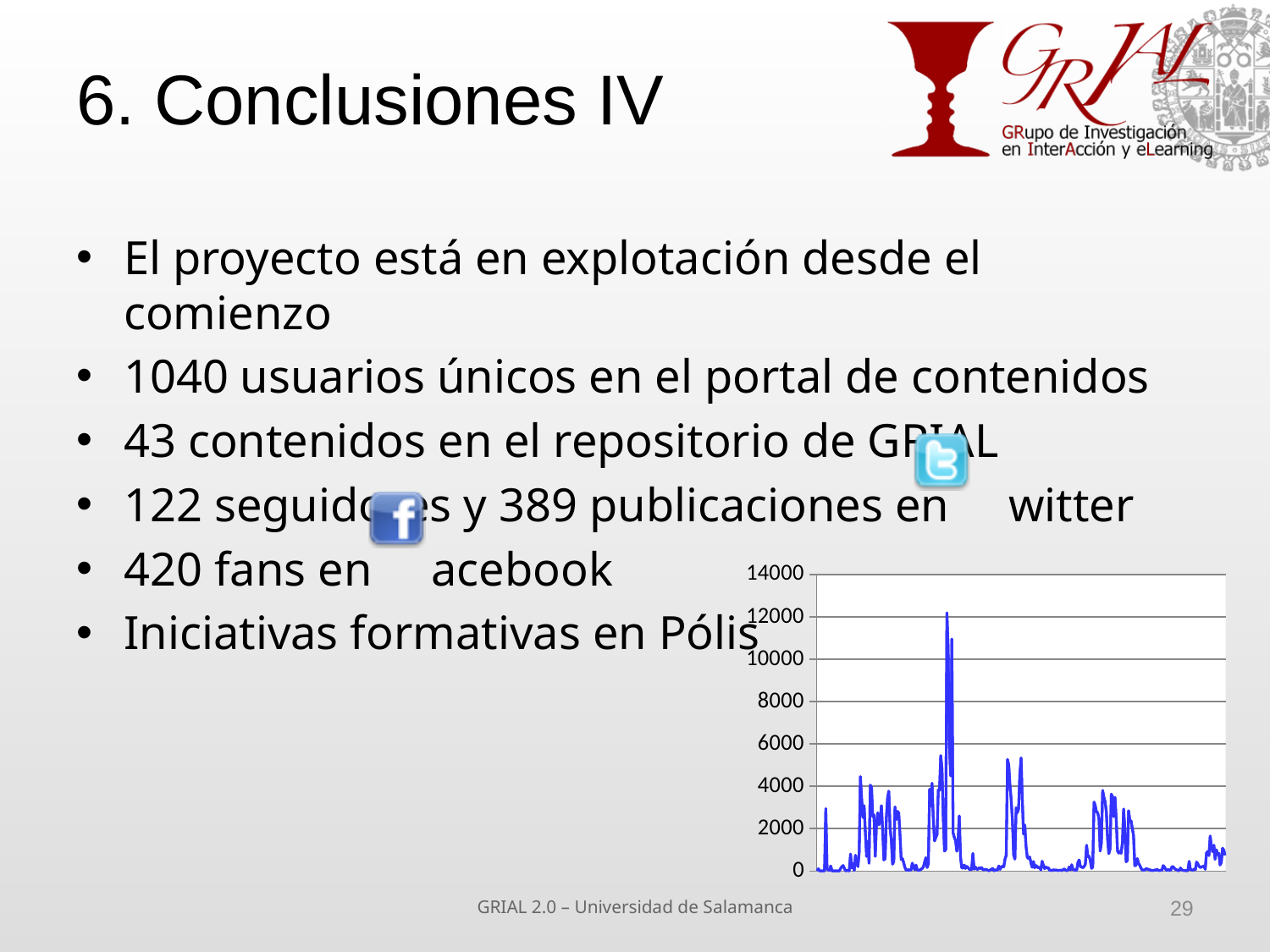
What colour is the line plotted in the chart at the bottom right of the slide? blue How many lines (series) are plotted in the chart at the bottom right of the slide? 1 What kind of chart is shown at the bottom right of the slide? line chart In the line chart at the bottom right, is the highest peak of the line greater or less than 10000? greater In the line chart at the bottom right, is the highest peak of the line greater or less than 14000? less What is the highest value shown on the vertical axis of the line chart at the bottom right? 14000 In the line chart at the bottom right, is the value at the far right end of the line greater or less than 4000? less